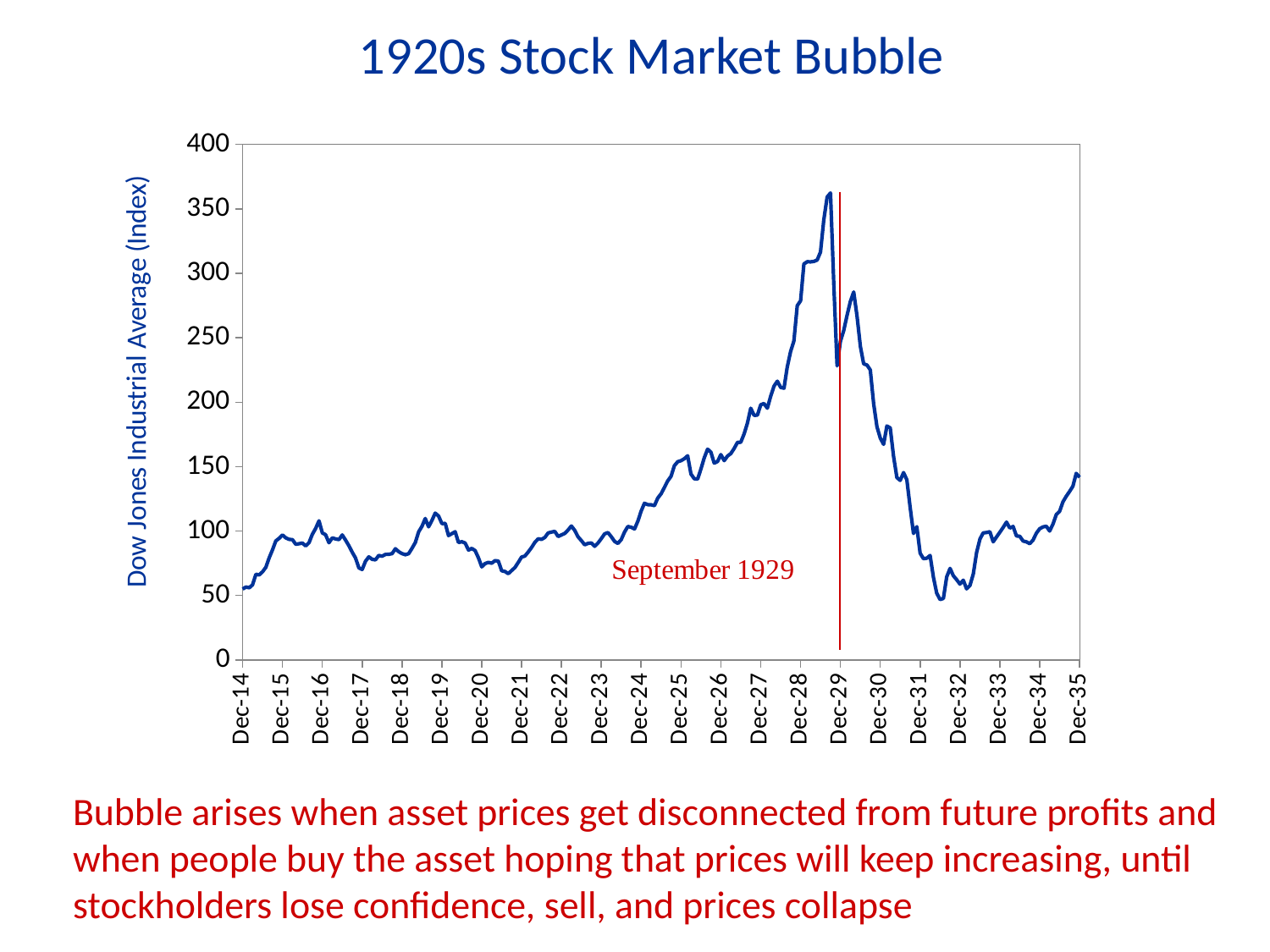
In which year does the Dow Jones Industrial Average reach its highest point on the chart? 1929 What kind of chart is shown on the slide? line chart Is the value of the Dow Jones Industrial Average at Dec-28 greater or less than 250? greater Does the Dow Jones Industrial Average rise or fall between Dec-24 and Dec-29? rise Is the value of the Dow Jones Industrial Average at Dec-32 greater or less than 100? less Does the Dow Jones Industrial Average rise or fall between Dec-29 and Dec-32? fall Is the value of the Dow Jones Industrial Average at Dec-14 greater or less than 100? less What is the title of the chart? 1920s Stock Market Bubble What is the label on the vertical axis of the chart? Dow Jones Industrial Average (Index) How many date labels are shown along the x axis of the chart? 22